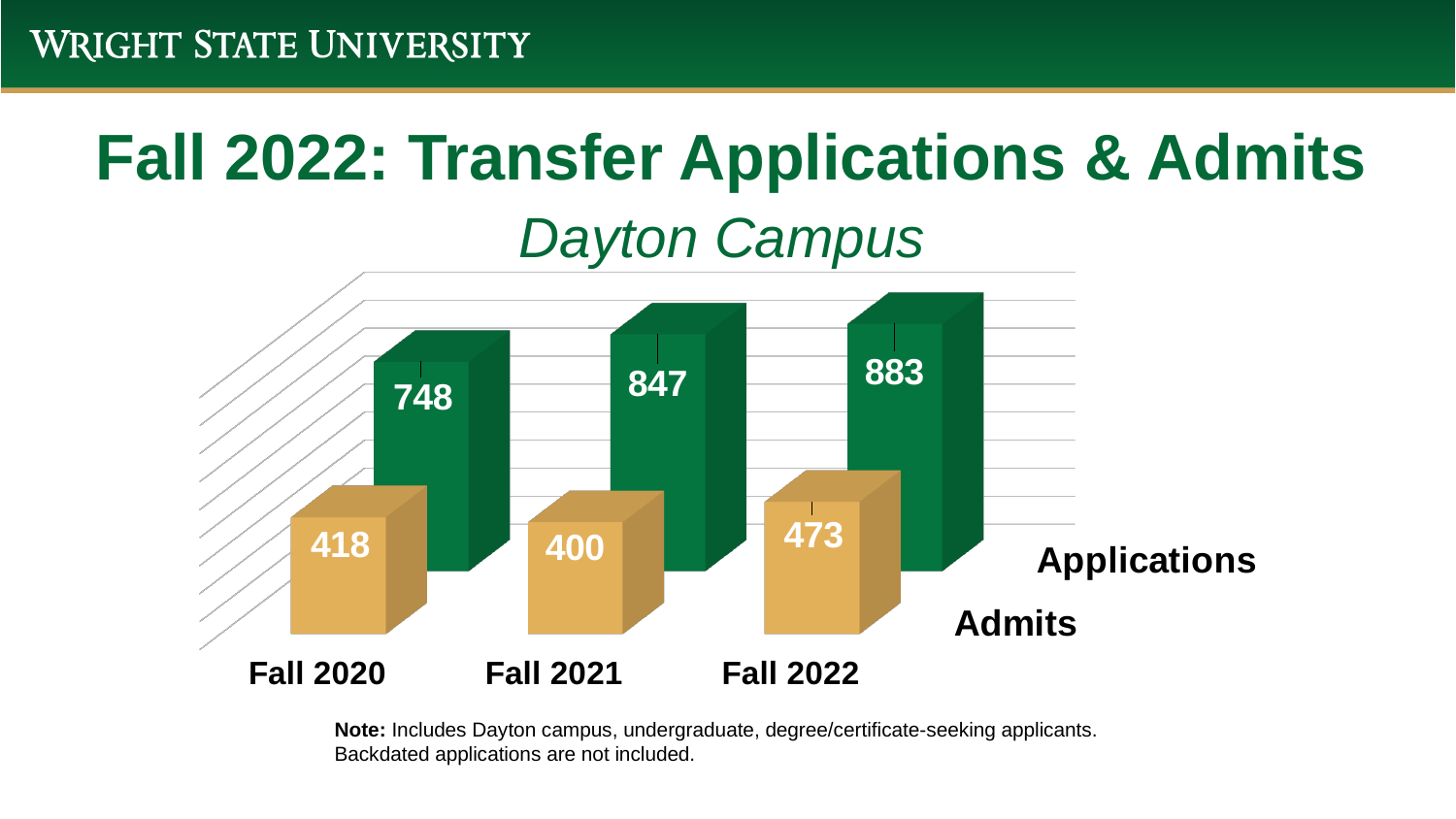
Which is larger, Admits in Fall 2020 or Admits in Fall 2022? Admits in Fall 2022 What is the number of Applications for Fall 2020? 748 Which term has the highest number of Applications? Fall 2022 How many terms are shown on the x axis? 3 How many series does the chart show? 2 What is the number of Admits for Fall 2021? 400 What is the number of Admits for Fall 2022? 473 What is the difference between Applications and Admits in Fall 2020? 330 What kind of chart is shown on the slide? Bar chart Do Applications rise or fall from Fall 2020 to Fall 2022? Rise Which term has the lowest number of Admits? Fall 2021 What is the difference between Applications in Fall 2022 and Fall 2021? 36